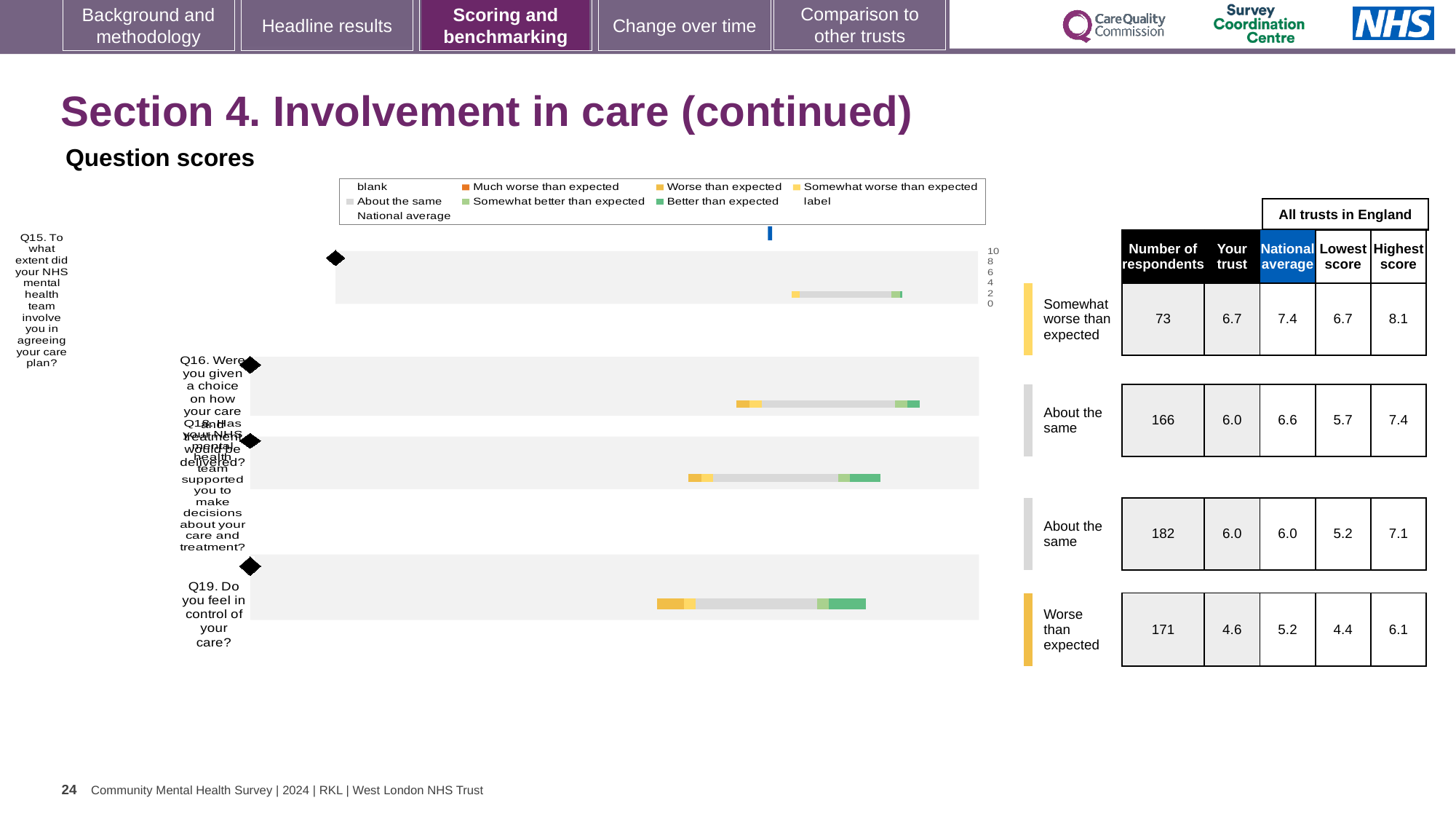
How many respondents answered Q18 (team supported you to make decisions)? 182 For Q15, how much higher is the national average than the 'Your trust' score? 0.7 What is the national average score for Q19 (feeling in control of your care)? 5.2 What kind of chart is used to show the question scores on this slide? bar chart What benchmark category is shown for Q19 (feeling in control of your care)? Worse than expected For Q19, what is the difference between the highest score and the lowest score across all trusts in England? 1.7 For Q16, which is larger: the 'Your trust' score or the national average? National average What is the 'Your trust' score for Q15 (involvement in agreeing your care plan)? 6.7 Which question has the lowest 'Your trust' score? Q19 Which question has the highest number of respondents? Q18 How many questions (rows) are plotted in the question scores chart? 4 What is the heading given to the chart on this slide? Question scores